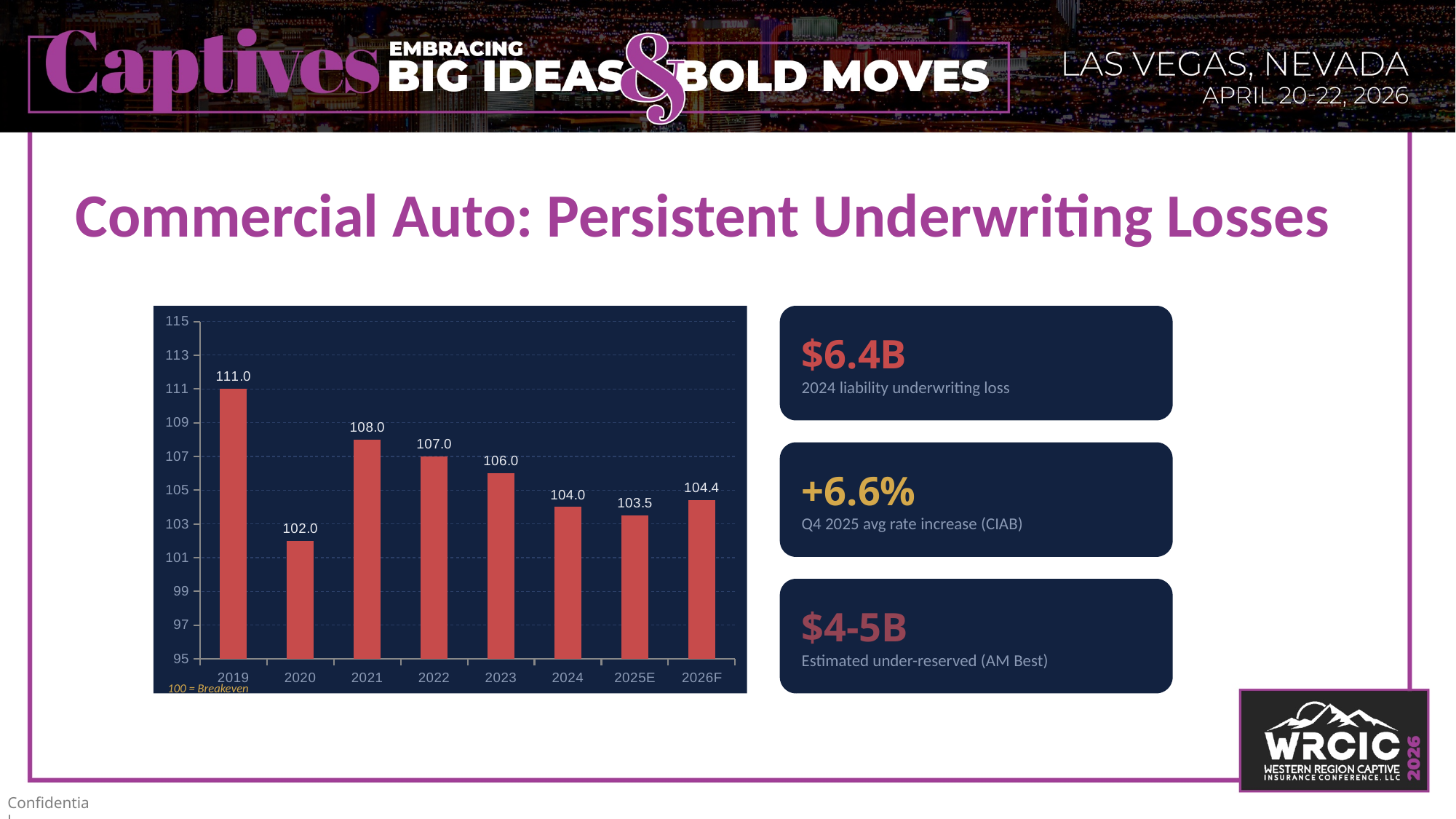
What kind of chart is shown on the slide? bar chart What is the value for 2019? 111.0 Which year has the lowest value? 2020 Is the value for 2021 greater or less than 105? greater Which is larger, the value for 2022 or the value for 2023? 2022 Do the values rise or fall from 2021 to 2025E? fall Which year has the highest value? 2019 What is the value for 2026F? 104.4 What is the difference between the values for 2019 and 2020? 9.0 What is the difference between the values for 2021 and 2024? 4.0 What is the value for 2025E? 103.5 How many years are shown on the x axis? 8